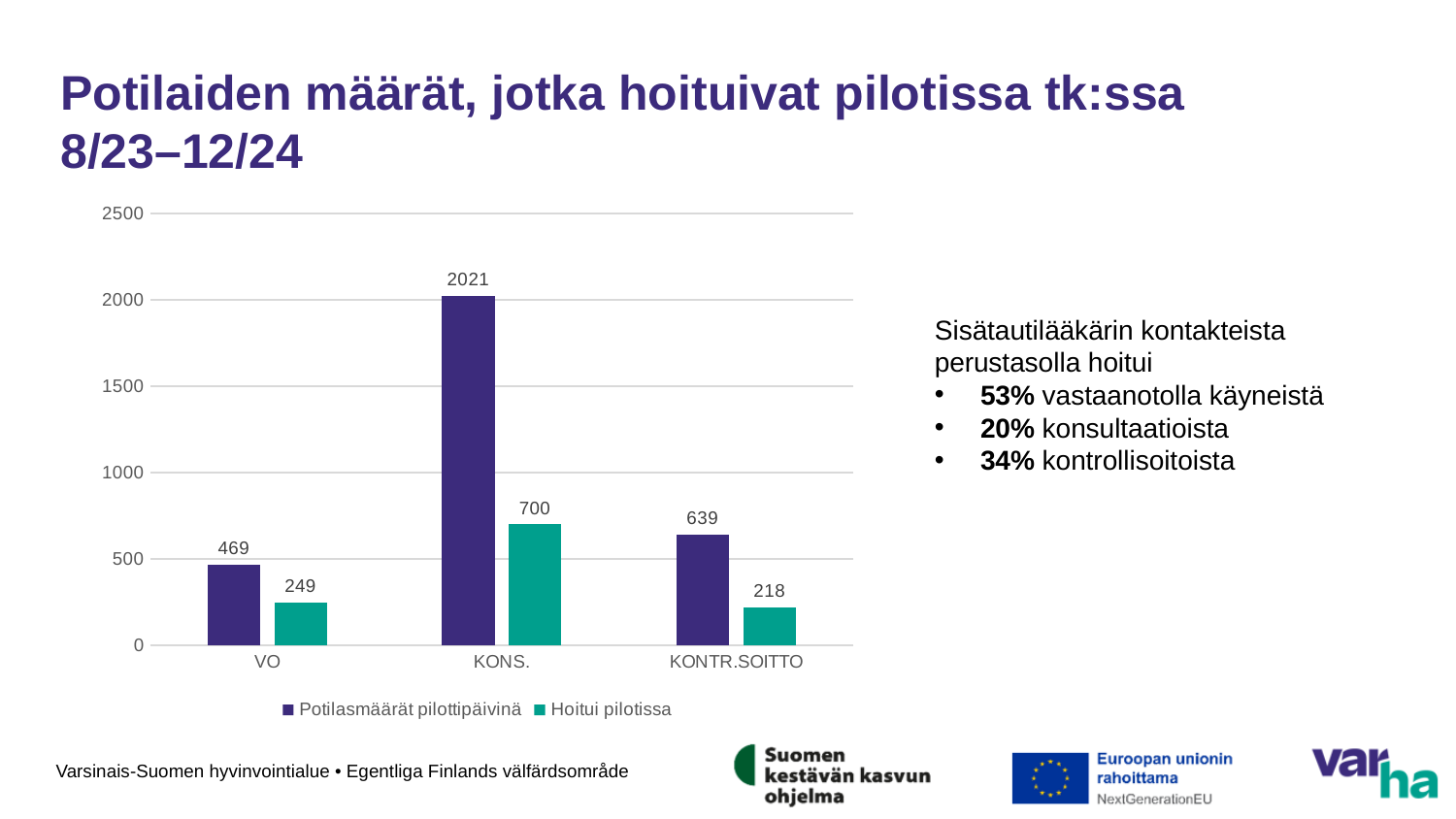
Which is larger: Potilasmäärät pilottipäivinä for VO or Potilasmäärät pilottipäivinä for KONTR.SOITTO? KONTR.SOITTO What is the difference between Potilasmäärät pilottipäivinä and Hoitui pilotissa for KONS.? 1321 Which category has the highest value for Potilasmäärät pilottipäivinä? KONS. Is the value of Hoitui pilotissa for KONS. greater or less than 500? greater What kind of chart is shown on the slide? bar chart How many series does the legend list? 2 How many categories are shown on the x axis? 3 What is the title of the slide? Potilaiden määrät, jotka hoituivat pilotissa tk:ssa 8/23–12/24 Which category has the lowest value for Hoitui pilotissa? KONTR.SOITTO What is the value of Hoitui pilotissa for VO? 249 What is the value of Hoitui pilotissa for KONTR.SOITTO? 218 What is the value of Potilasmäärät pilottipäivinä for KONS.? 2021